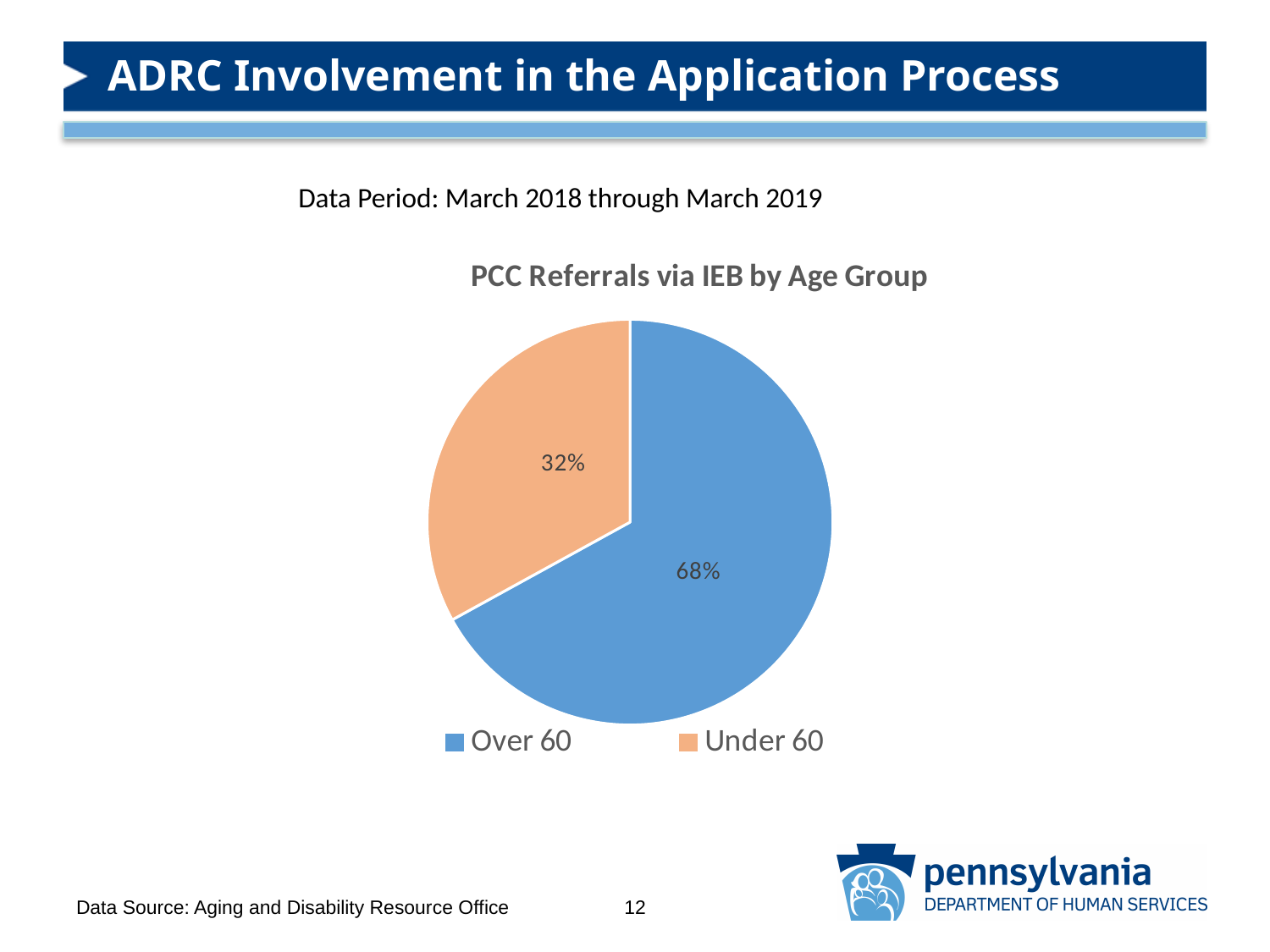
What is the title of the chart? PCC Referrals via IEB by Age Group Which age group has the largest share of PCC referrals via IEB? Over 60 What share of PCC referrals via IEB is for the Under 60 age group? 32% Is the share for Over 60 greater or less than 50%? greater How many slices does the pie chart have? 2 How many entries does the legend list? 2 Which age group has the smallest share of PCC referrals via IEB? Under 60 What colour is the Under 60 slice? orange What share of PCC referrals via IEB is for the Over 60 age group? 68% What is the difference in percentage points between the Over 60 and Under 60 shares? 36 Which is larger, the share for Over 60 or the share for Under 60? Over 60 What type of chart is shown on the slide? pie chart